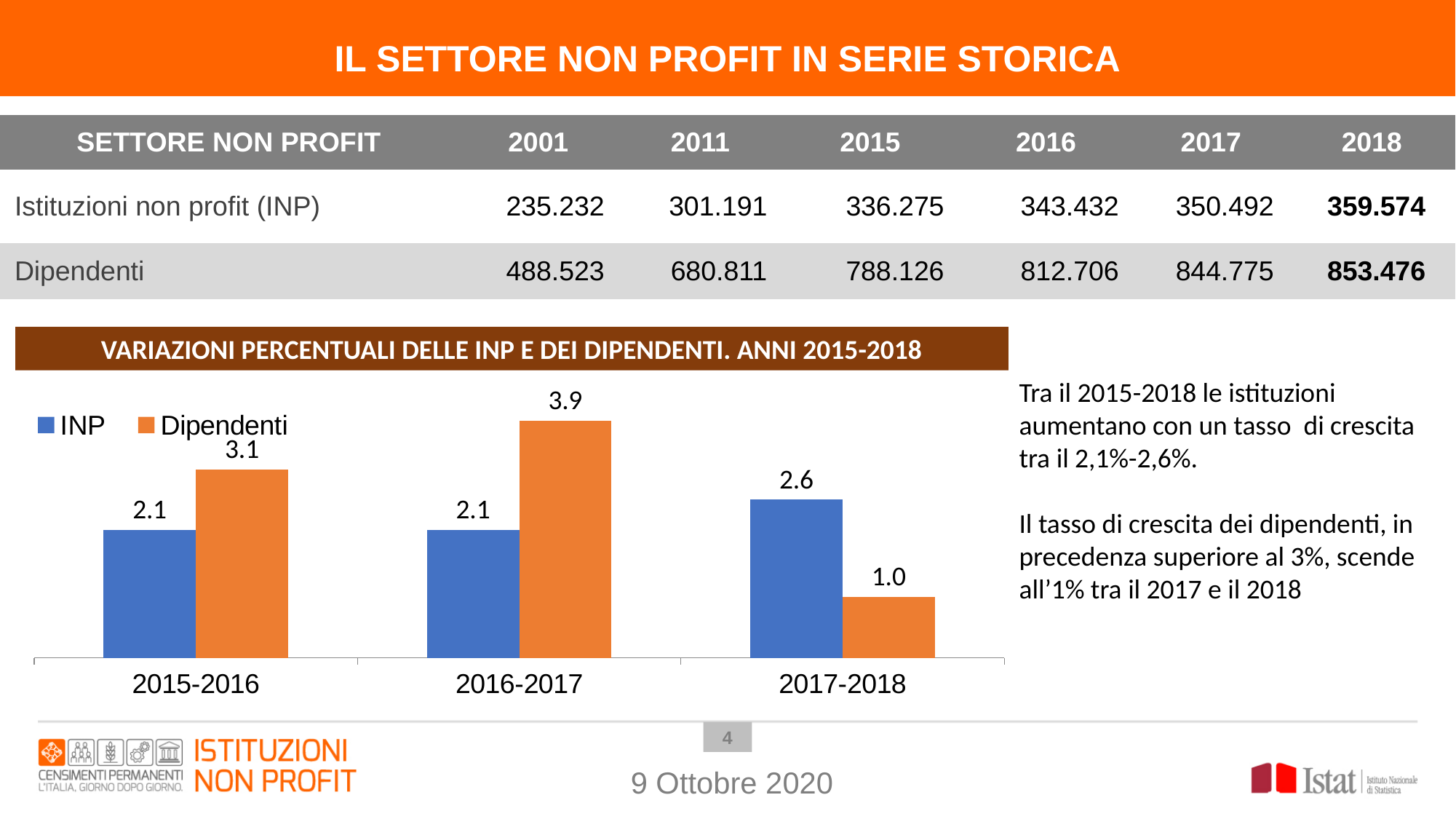
What colour are the Dipendenti bars in the chart? Orange In which period is the Dipendenti value highest? 2016-2017 What is the value for Dipendenti in 2017-2018? 1.0 How many series does the chart legend list? 2 What kind of chart is shown on the slide? Bar chart Which is larger in 2017-2018, INP or Dipendenti? INP What is the value for INP in 2015-2016? 2.1 What is the value for INP in 2017-2018? 2.6 What is the value for Dipendenti in 2016-2017? 3.9 In which period is the Dipendenti value lowest? 2017-2018 How many periods are shown on the x axis of the chart? 3 What is the difference between the Dipendenti and INP values in 2016-2017? 1.8